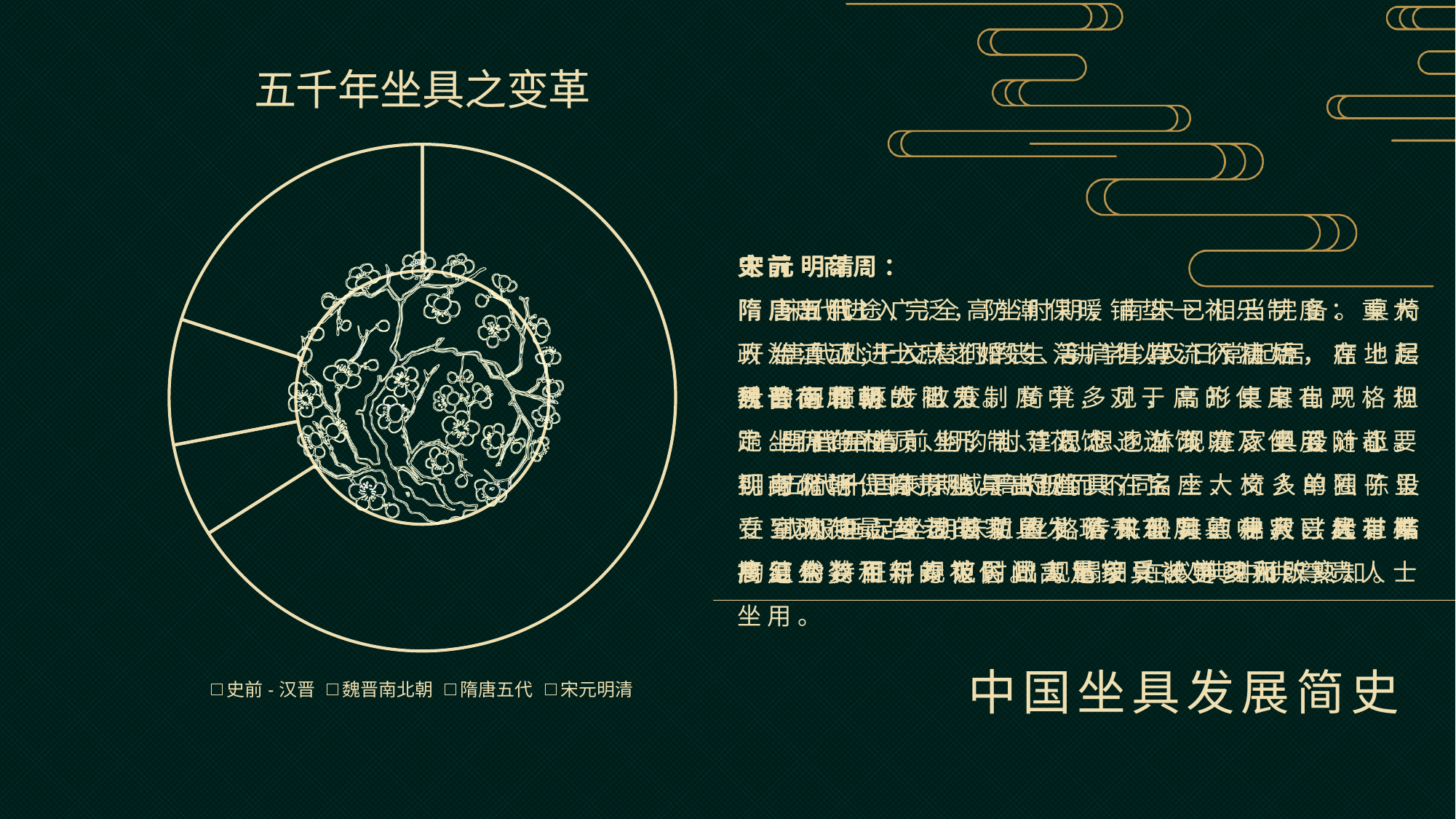
What is the first category listed in the chart's legend? 史前 - 汉晋 What is the title of the chart? 五千年坐具之变革 How many slices does the doughnut chart have? 4 Which category occupies the largest slice of the doughnut chart? 史前 - 汉晋 How many categories does the legend of the chart list? 4 What kind of chart is shown on the slide? doughnut chart